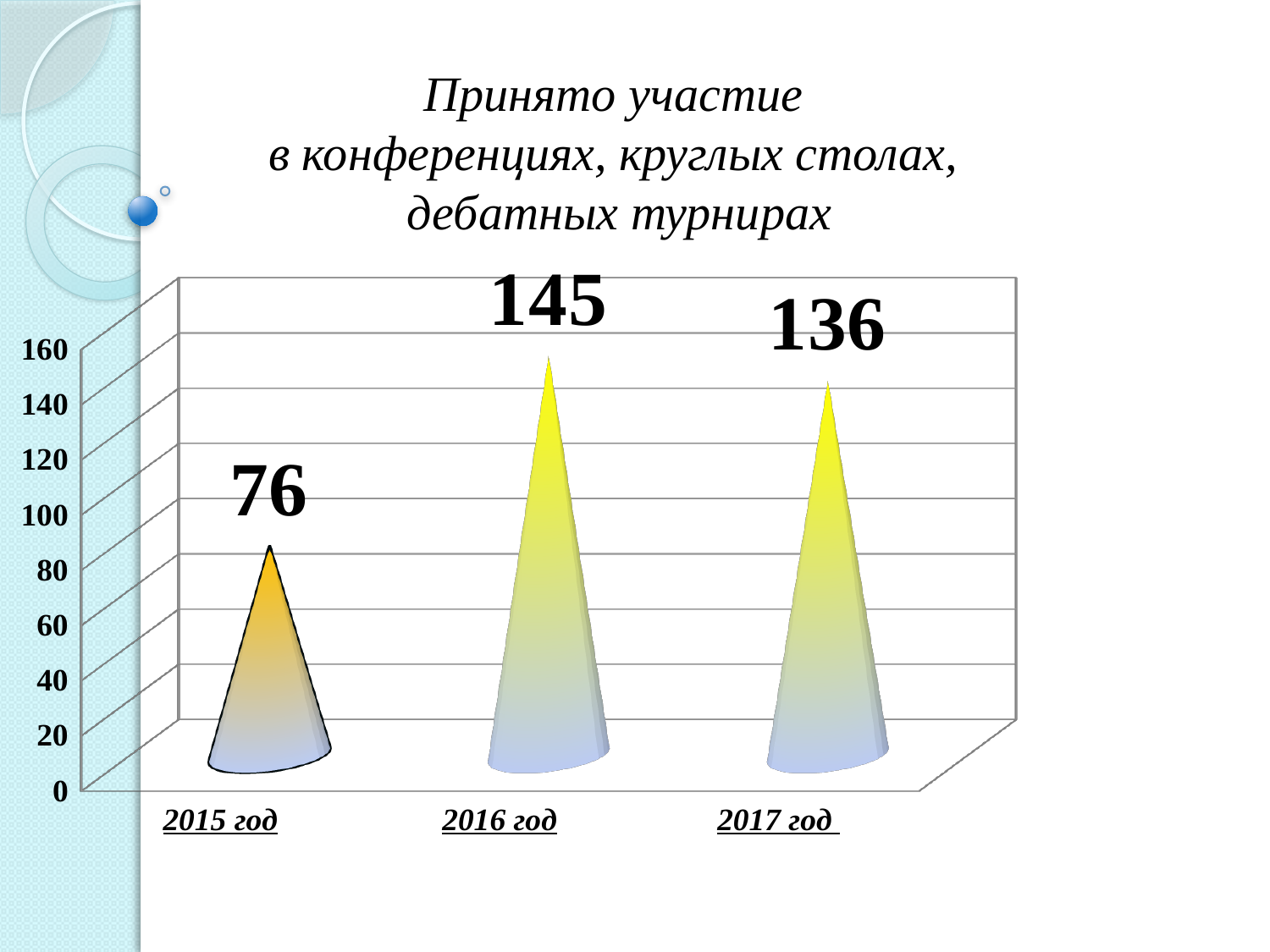
What is the value for 2016 год? 145 Is the value for 2015 год greater or less than 100? less What is the difference between the values for 2016 год and 2017 год? 9 Which is larger, the value for 2017 год or the value for 2015 год? 2017 год What is the value for 2015 год? 76 How many years are shown on the chart? 3 Which year has the highest value? 2016 год Which year has the lowest value? 2015 год What is the difference between the values for 2016 год and 2015 год? 69 What is the title of the chart? Принято участие в конференциях, круглых столах, дебатных турнирах What kind of chart is shown on the slide? bar chart What is the value for 2017 год? 136